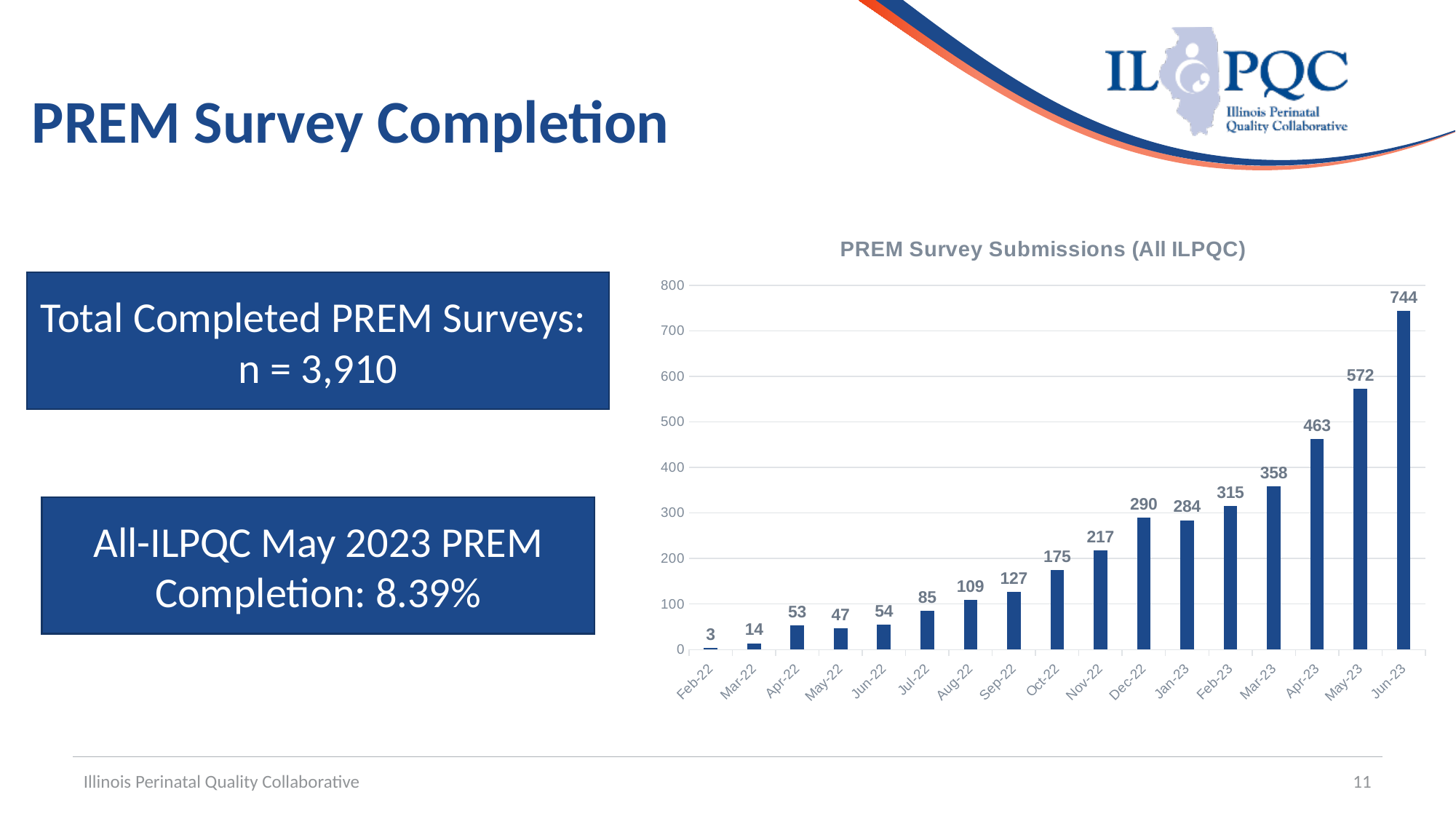
Which month has the highest number of PREM survey submissions? Jun-23 What is the value for Jun-23 in the PREM Survey Submissions chart? 744 What is the value for Oct-22 in the PREM Survey Submissions chart? 175 What is the difference between the Jun-23 and May-23 values in the PREM Survey Submissions chart? 172 What is the value for Feb-22 in the PREM Survey Submissions chart? 3 Is the value for Apr-23 greater or less than 400? greater How many months are shown on the x axis of the PREM Survey Submissions chart? 17 Do the values in the PREM Survey Submissions chart generally rise or fall from Feb-22 to Jun-23? Rise Which month has the lowest number of PREM survey submissions? Feb-22 What kind of chart is the PREM Survey Submissions chart? Bar chart Which is larger in the PREM Survey Submissions chart, Dec-22 or Jan-23? Dec-22 What is the title of the chart on the slide? PREM Survey Submissions (All ILPQC)